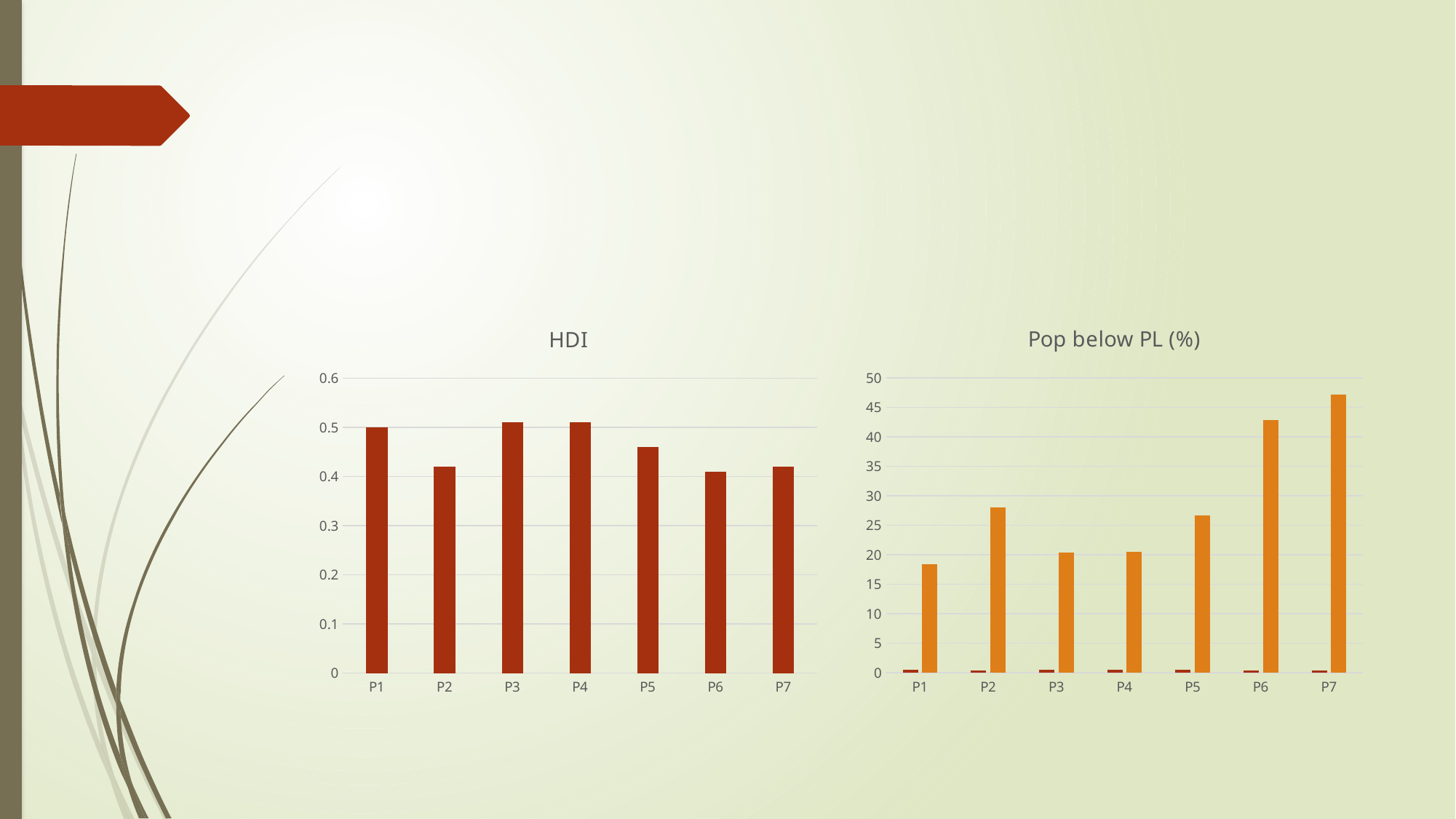
In the Pop below PL (%) chart, which category has the highest orange bar? P7 In the Pop below PL (%) chart, which category has the lowest orange bar? P1 What is the title of the chart on the right side of the slide? Pop below PL (%) In the HDI chart, is the value for P1 greater or less than the value for P2? greater What kind of chart is the HDI chart? bar chart In the HDI chart, is the value for P5 greater or less than the value for P6? greater In the HDI chart, is the value for P6 greater or less than 0.5? less In the HDI chart, is the value for P3 greater or less than 0.4? greater In the Pop below PL (%) chart, is the orange bar for P7 greater or less than 45? greater In the Pop below PL (%) chart, is the orange bar for P6 greater or less than the orange bar for P2? greater How many categories are shown on the x axis of the HDI chart? 7